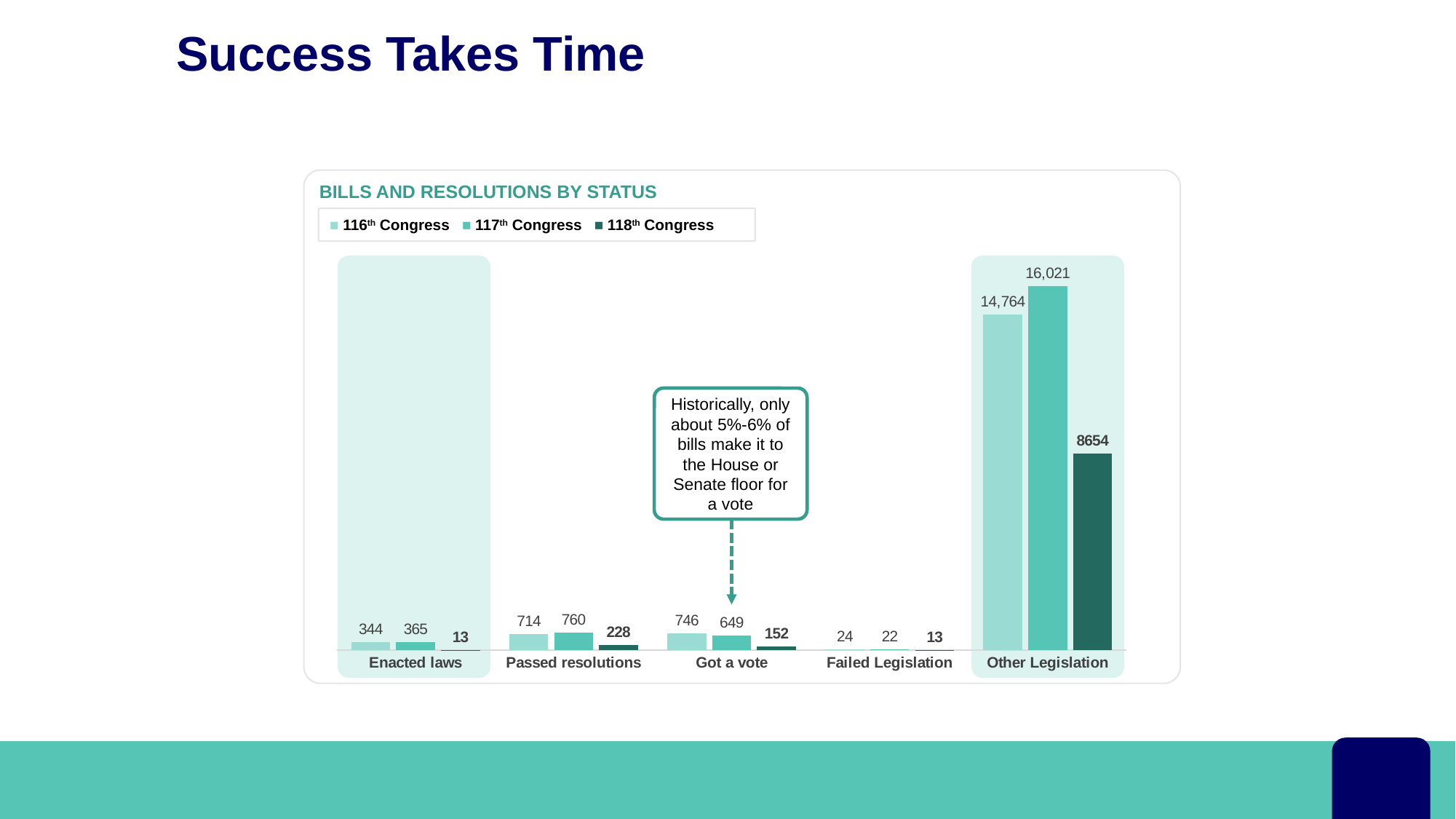
How many series does the legend list? 3 Which category has the highest value for the 117th Congress? Other Legislation What is the title of the chart? BILLS AND RESOLUTIONS BY STATUS How many categories are shown on the x axis? 5 What is the value for Enacted laws in the 116th Congress? 344 Which category has the lowest value for the 116th Congress? Failed Legislation What is the value for Failed Legislation in the 117th Congress? 22 What is the difference between the 117th Congress and 116th Congress values for Passed resolutions? 46 What kind of chart is shown on the slide? Bar chart What is the value for Got a vote in the 118th Congress? 152 What is the value for Other Legislation in the 117th Congress? 16,021 Which is larger for Got a vote: the 116th Congress value or the 117th Congress value? 116th Congress